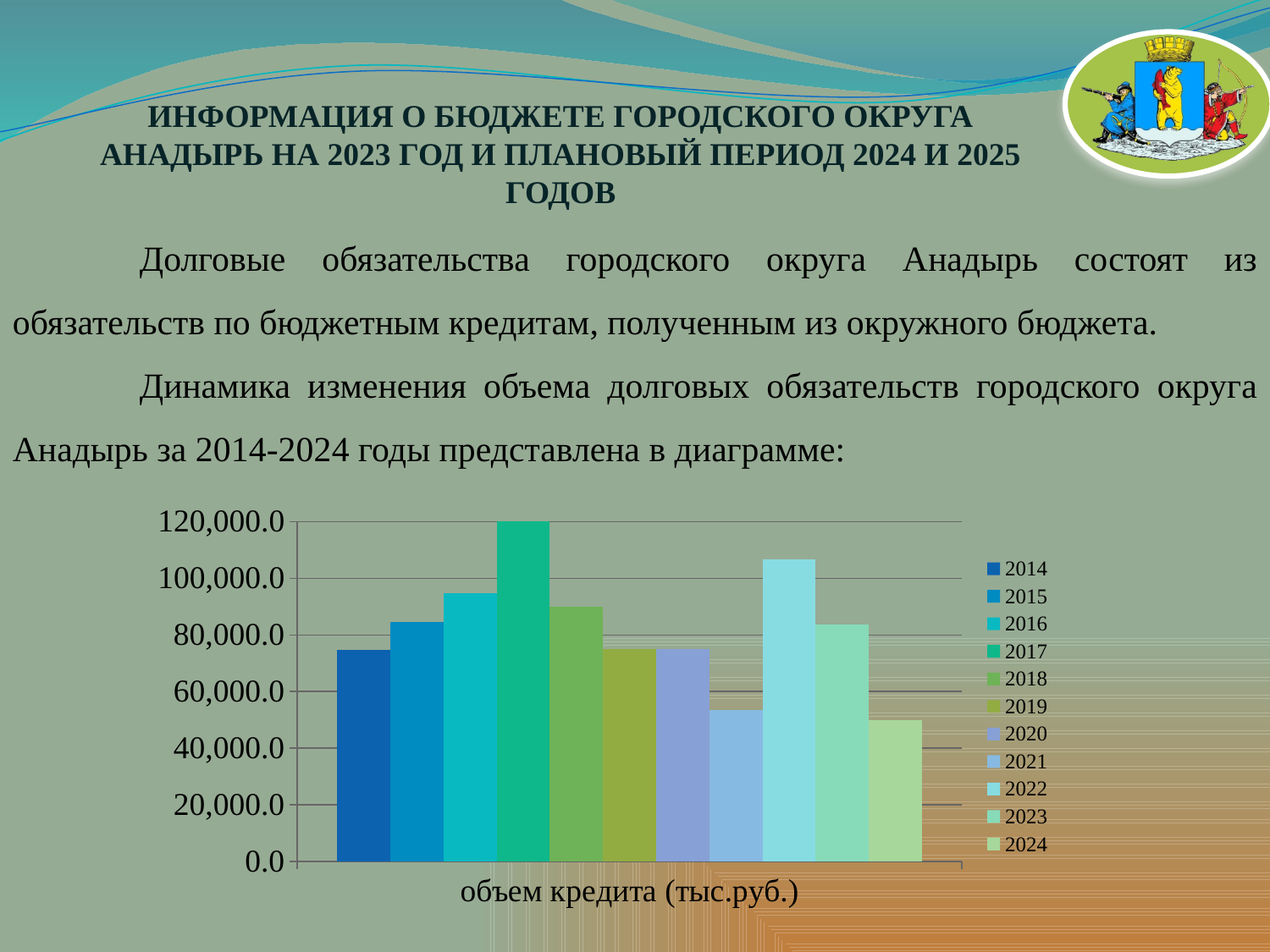
Which is larger, the value for 2022 or the value for 2023? 2022 Is the value for 2024 greater or less than 60,000.0? less Which is larger, the value for 2015 or the value for 2021? 2015 How many series does the legend list? 11 Is the value for 2018 greater or less than 100,000.0? less Is the value for 2022 greater or less than 100,000.0? greater What is the label shown under the x axis of the chart? объем кредита (тыс.руб.) What is the value for 2017? 120,000.0 Which year has the highest value in the chart? 2017 What kind of chart is shown on the slide? bar chart